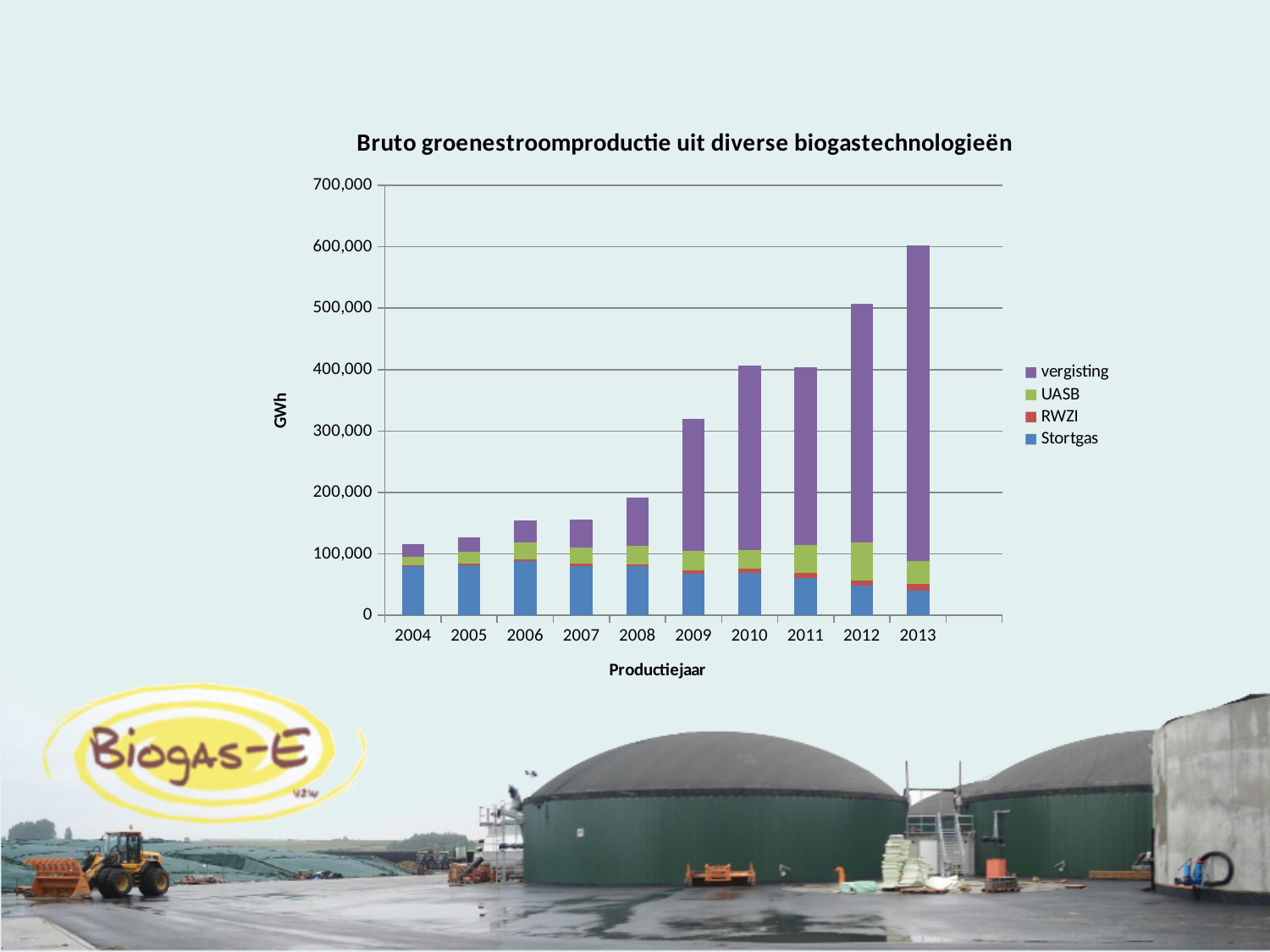
What is the label on the y axis of the chart? GWh How many series does the legend list? 4 Is the total value for 2004 greater or less than 200,000? less Which year has the lowest total green electricity production? 2004 What kind of chart is shown on the slide? Stacked bar chart Is the total value for 2013 greater or less than 500,000? greater Which year has the highest total green electricity production? 2013 Is the total value for 2009 greater or less than 300,000? greater Which year has the larger total production, 2009 or 2012? 2012 Do the total values generally rise or fall from 2004 to 2013? rise How many production years are shown on the x axis? 10